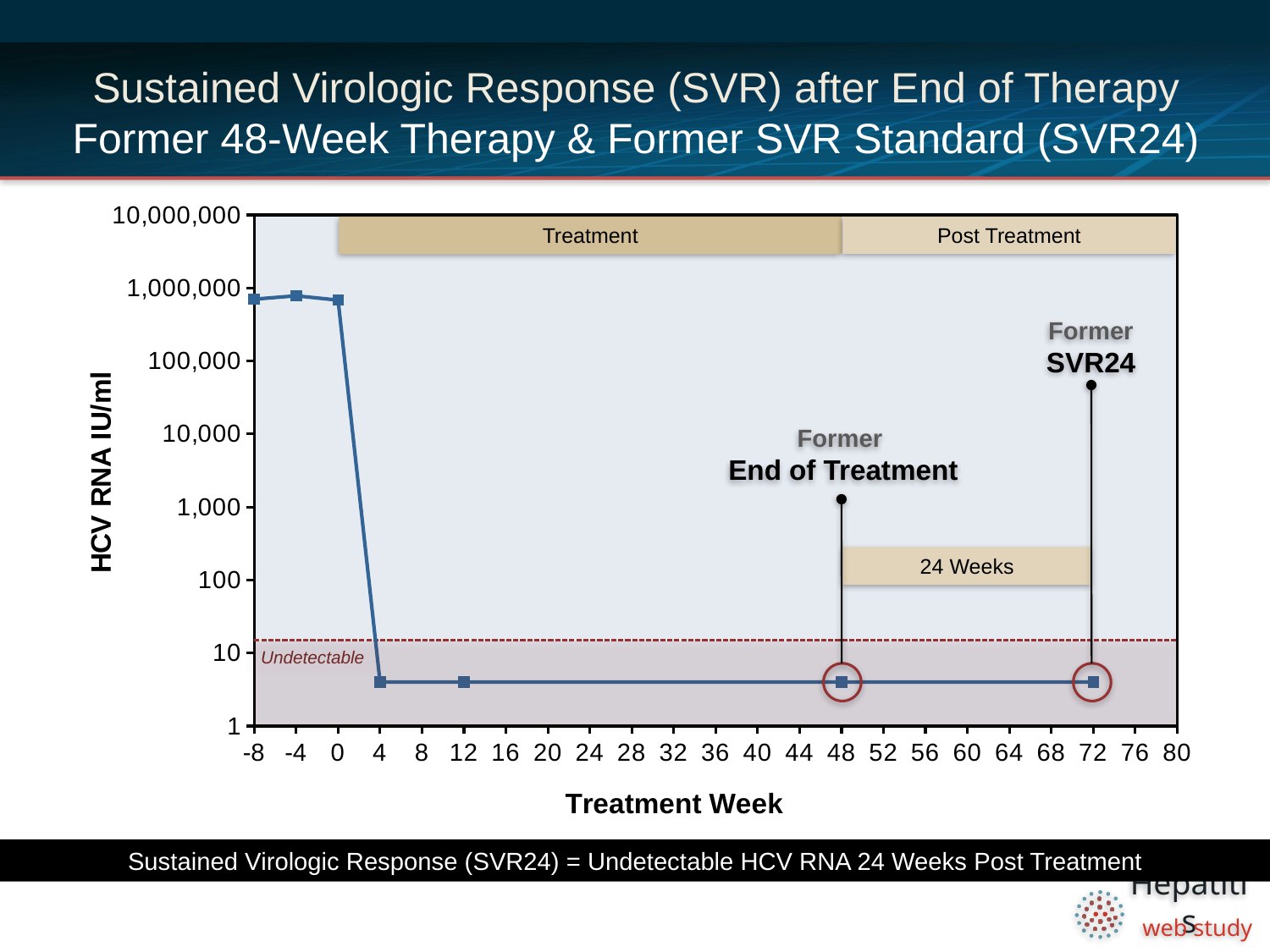
What kind of chart is shown on the slide? line chart What is the title of the y axis? HCV RNA IU/ml How many data points are marked on the line? 7 What is the title of the x axis? Treatment Week Is the HCV RNA value at treatment week 0 greater or less than 100,000? greater Does the HCV RNA value rise or fall between treatment week 0 and treatment week 4? fall Is the HCV RNA value at treatment week 4 greater or less than 10? less Is the HCV RNA value at treatment week 72 greater or less than 100? less Which has the larger HCV RNA value, treatment week 0 or treatment week 12? treatment week 0 Which has the larger HCV RNA value, treatment week -4 or treatment week 48? treatment week -4